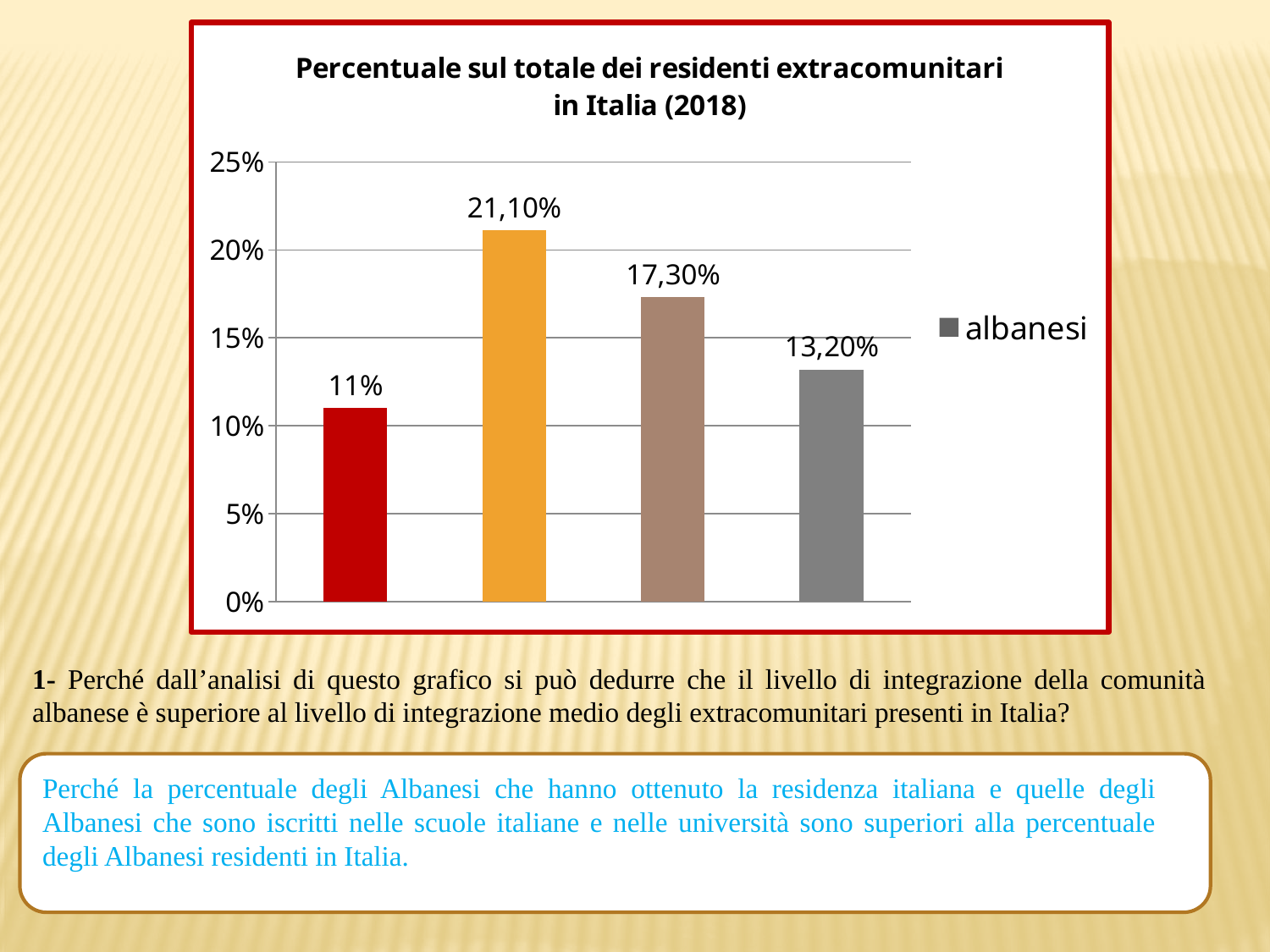
What is the difference between the second (orange) bar and the fourth (grey) bar? 7,90% Which bar has the highest value in the chart? The second (orange) bar, 21,10% What is the value shown on the fourth (grey) bar of the chart? 13,20% What is the only entry listed in the chart's legend? albanesi What is the value shown on the third (brown) bar of the chart? 17,30% Is the value of the first (red) bar greater or less than 15%? less Which is larger, the third (brown) bar or the fourth (grey) bar? The third (brown) bar Which bar has the lowest value in the chart? The first (red) bar, 11% How many bars are plotted in the chart? 4 What is the value shown on the second (orange) bar of the chart? 21,10% What type of chart is shown on the slide? Bar chart What is the value shown on the first (red) bar of the chart? 11%